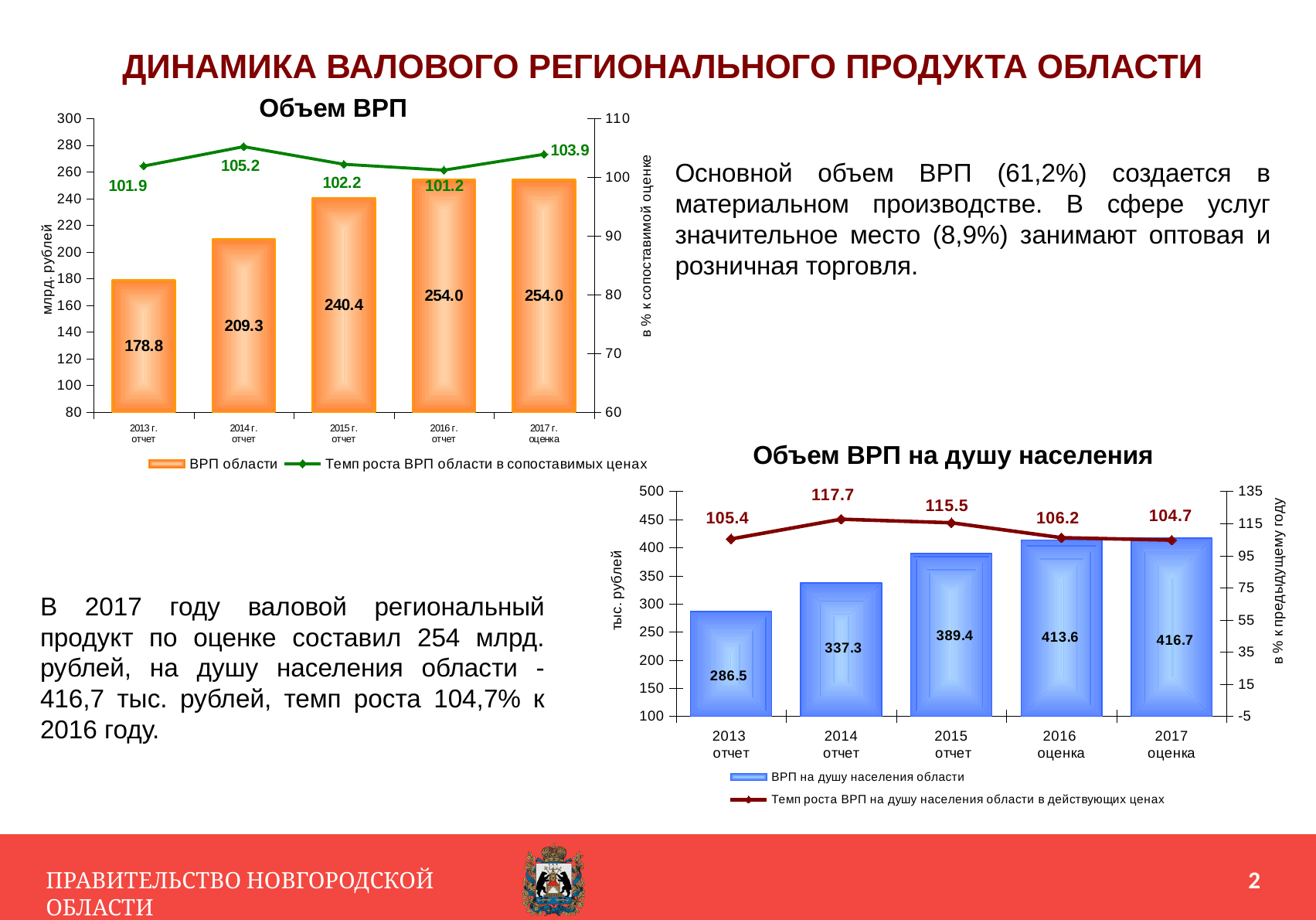
In the chart "Объем ВРП", which year has the highest value of Темп роста ВРП области в сопоставимых ценах? 2014 г. отчет In the chart "Объем ВРП", how many series does the legend list? 2 In the chart "Объем ВРП на душу населения", which year has the highest value of ВРП на душу населения области? 2017 оценка In the chart "Объем ВРП", what is the value of Темп роста ВРП области в сопоставимых ценах for 2014 г. отчет? 105.2 In the chart "Объем ВРП", what is the difference between ВРП области in 2014 г. отчет and 2013 г. отчет? 30.5 In the chart "Объем ВРП на душу населения", how many years are shown on the x axis? 5 In the chart "Объем ВРП на душу населения", what is the value of Темп роста ВРП на душу населения области в действующих ценах for 2017 оценка? 104.7 In the chart "Объем ВРП", what is the value of ВРП области for 2015 г. отчет? 240.4 In the chart "Объем ВРП на душу населения", do the values of ВРП на душу населения области rise or fall from 2013 to 2017? Rise In the chart "Объем ВРП на душу населения", what is the value of ВРП на душу населения области for 2016 оценка? 413.6 In the chart "Объем ВРП", which year has the lowest value of ВРП области? 2013 г. отчет In the chart "Объем ВРП на душу населения", is the value of ВРП на душу населения области for 2014 отчет larger than for 2013 отчет? Yes